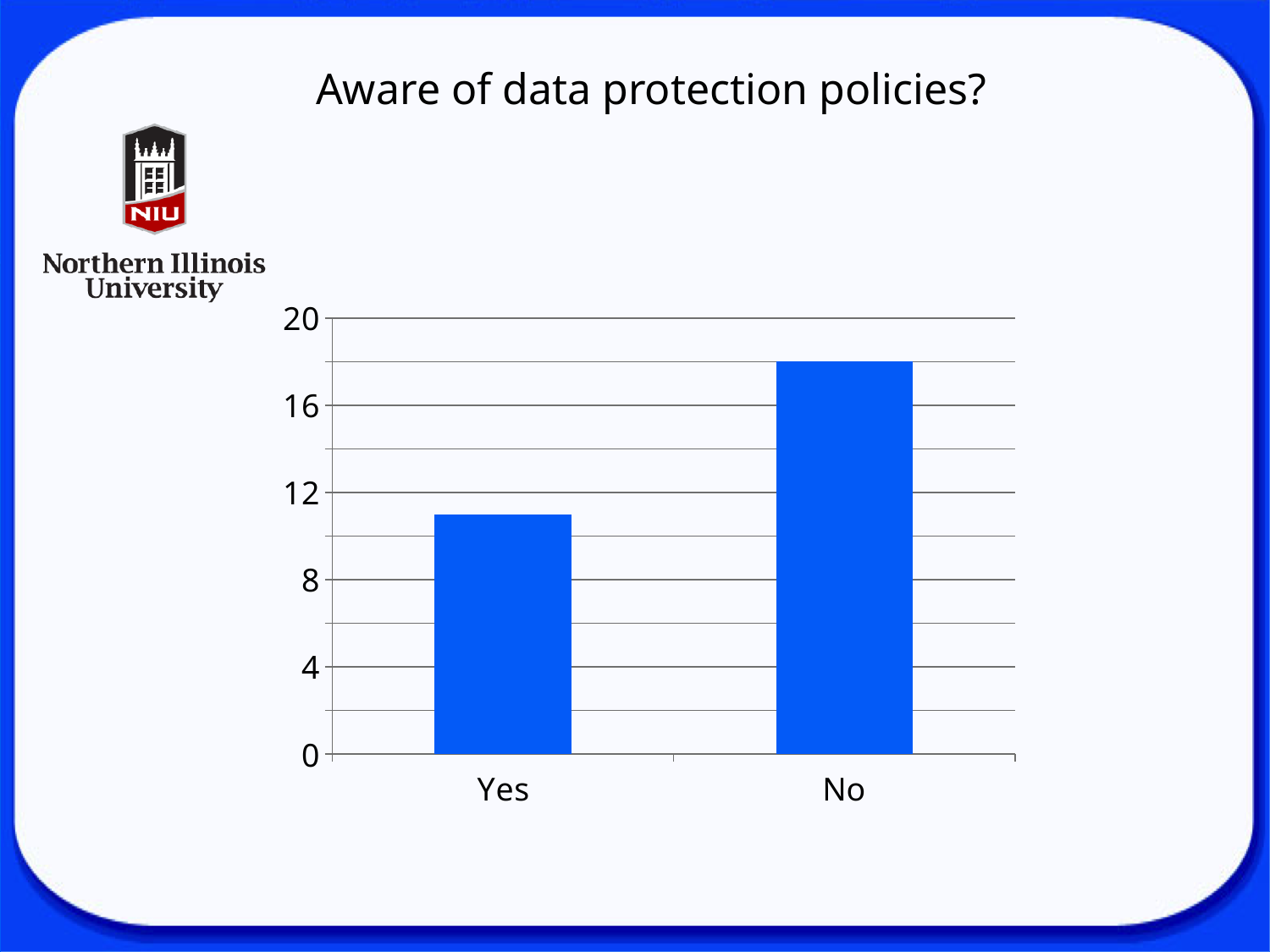
What kind of chart is shown on the slide? bar chart Which is larger, the value for Yes or the value for No? No Is the value for No greater or less than 16? greater Is the value for No greater or less than 20? less Is the value for Yes greater or less than 8? greater Do the values rise or fall from Yes to No along the x axis? rise Which category has the lowest value? Yes What is the title of the chart? Aware of data protection policies? Which category has the highest value? No What is the highest value labelled on the vertical axis? 20 How many categories are shown on the x axis? 2